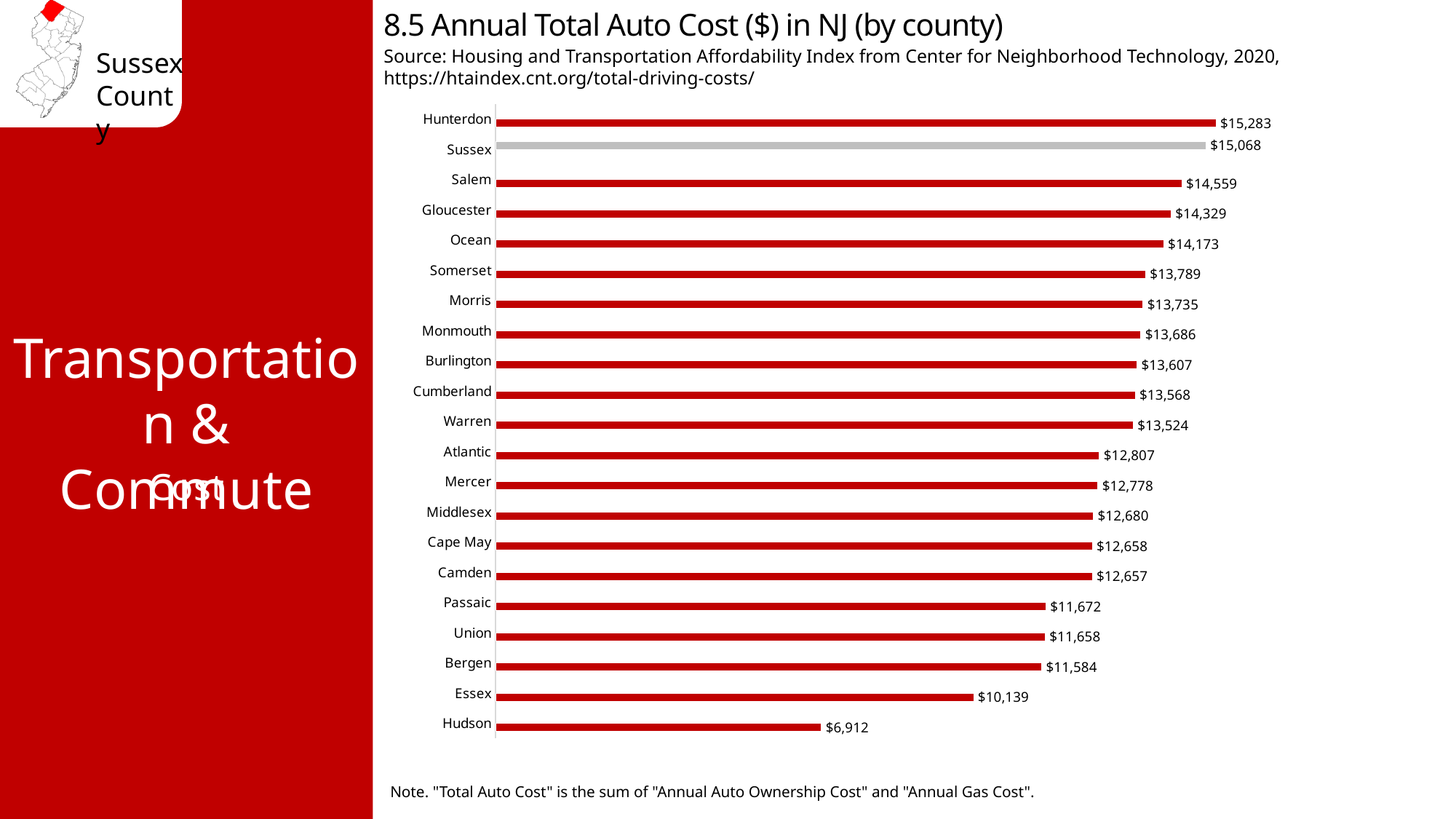
Which county's bar is shown in grey instead of red? Sussex Which county has a higher annual total auto cost, Salem or Ocean? Salem What is the difference in annual total auto cost between Essex and Hudson? $3,227 Which county has a higher annual total auto cost, Bergen or Essex? Bergen Which county has the lowest annual total auto cost? Hudson What is the annual total auto cost for Hudson County? $6,912 What is the difference in annual total auto cost between Hunterdon and Sussex? $215 Which county has the highest annual total auto cost? Hunterdon What type of chart is used to show annual total auto cost by county? Bar chart What is the annual total auto cost for Sussex County? $15,068 How many counties are shown in the chart? 21 What is the annual total auto cost for Morris County? $13,735